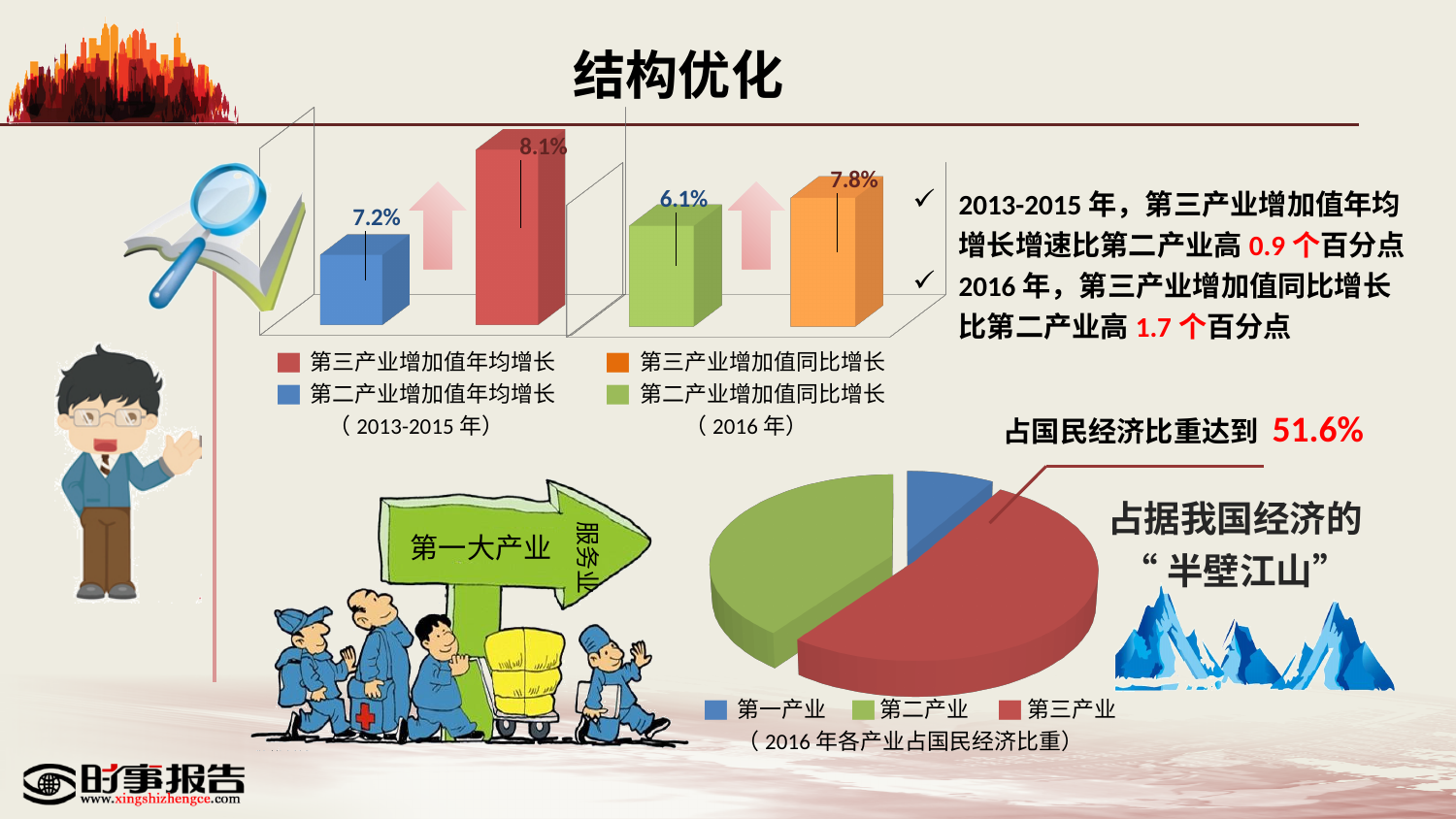
How many categories does the legend of the pie chart at the bottom of the slide list? 3 In the bar chart at the top of the slide, which bar has the highest value? 第三产业增加值年均增长 (2013-2015年) In the bar chart at the top of the slide, what is the value for 第二产业增加值同比增长 (2016年)? 6.1% In the pie chart at the bottom of the slide, what share does 第三产业 hold? 51.6% In the bar chart at the top of the slide, what is the difference between 第三产业增加值同比增长 and 第二产业增加值同比增长 for 2016年? 1.7 percentage points In the bar chart at the top of the slide, what is the value for 第三产业增加值同比增长 (2016年)? 7.8% In the bar chart at the top of the slide, what is the difference between 第三产业增加值年均增长 and 第二产业增加值年均增长 for 2013-2015年? 0.9 percentage points In the bar chart at the top of the slide, what is the value for 第二产业增加值年均增长 (2013-2015年)? 7.2% In the bar chart at the top of the slide, which is larger: 第三产业增加值同比增长 (2016年) or 第二产业增加值年均增长 (2013-2015年)? 第三产业增加值同比增长 (2016年) In the bar chart at the top of the slide, what is the value for 第三产业增加值年均增长 (2013-2015年)? 8.1% How many bars are plotted in the bar chart at the top of the slide? 4 In the bar chart at the top of the slide, which bar has the lowest value? 第二产业增加值同比增长 (2016年)